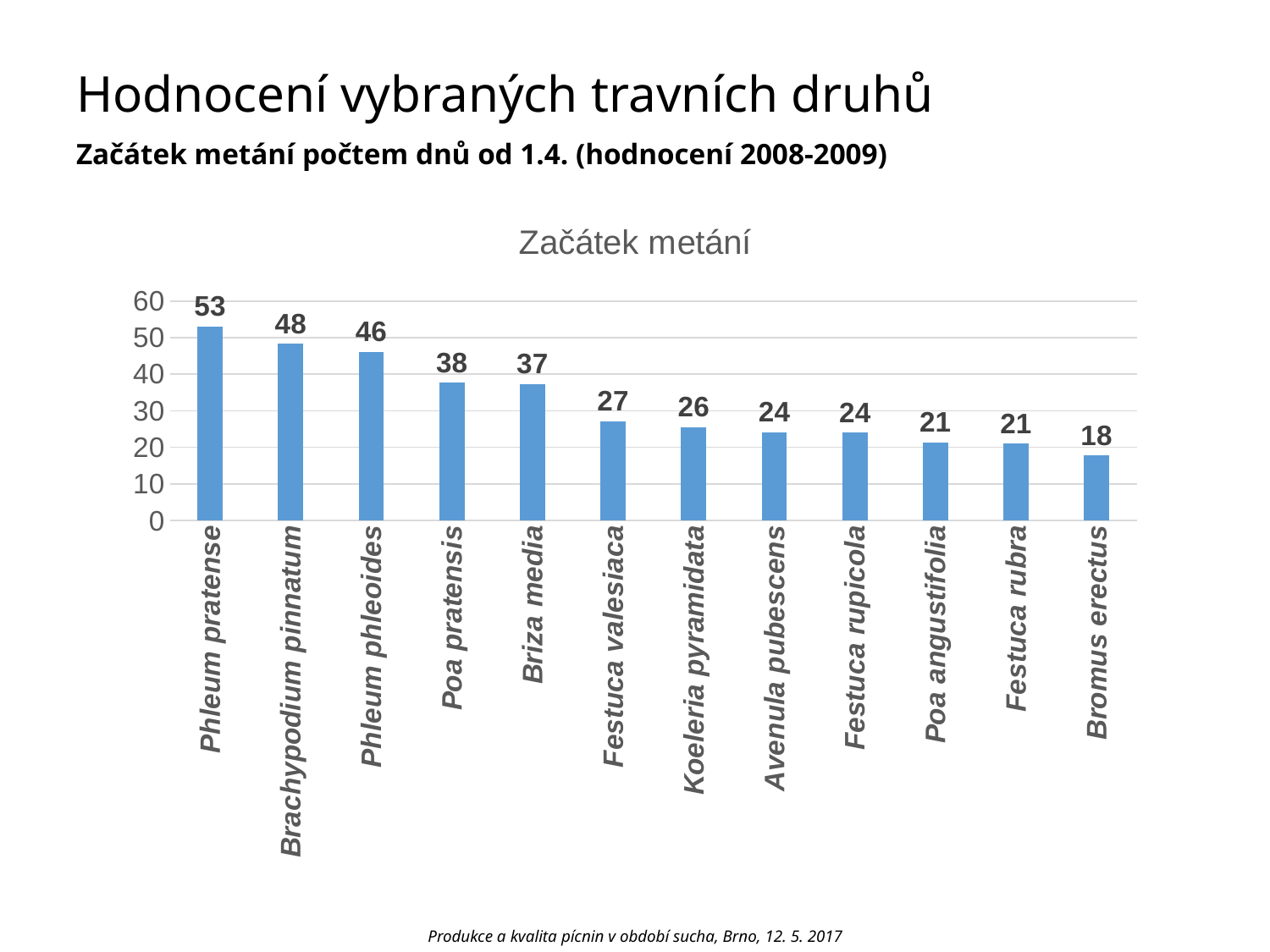
What is the value for Briza media? 37 What is the value for Poa angustifolia? 21 What kind of chart is shown on the slide? bar chart Is the value for Phleum phleoides greater or less than 40? greater Which category has the highest value? Phleum pratense What is the value for Phleum pratense? 53 Which is larger, the value for Festuca valesiaca or the value for Koeleria pyramidata? Festuca valesiaca What is the difference between the values for Brachypodium pinnatum and Poa pratensis? 10 What is the title of the chart? Začátek metání What is the difference between the values for Phleum pratense and Bromus erectus? 35 Which category has the lowest value? Bromus erectus How many categories are shown on the x axis? 12